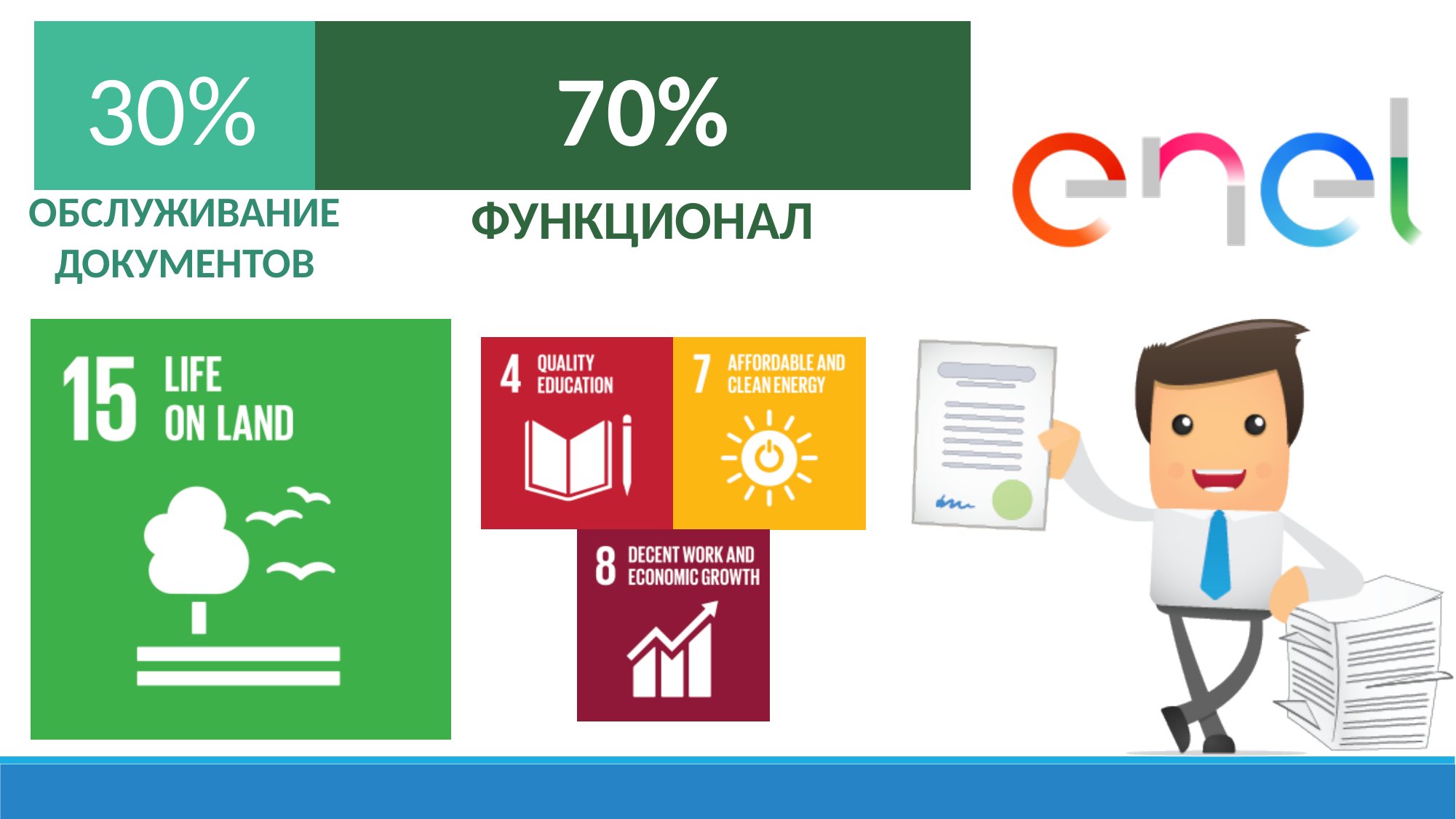
What is the difference between the ФУНКЦИОНАЛ share and the ОБСЛУЖИВАНИЕ ДОКУМЕНТОВ share? 40% Which segment has the larger share, ОБСЛУЖИВАНИЕ ДОКУМЕНТОВ or ФУНКЦИОНАЛ? ФУНКЦИОНАЛ How many segments does the bar have? 2 Which category has the smallest share in the bar? ОБСЛУЖИВАНИЕ ДОКУМЕНТОВ Which colour is the ФУНКЦИОНАЛ segment, light green or dark green? Dark green What percentage is shown for ОБСЛУЖИВАНИЕ ДОКУМЕНТОВ? 30% What percentage is shown for ФУНКЦИОНАЛ? 70% What is the total of the two segments in the bar? 100% What kind of chart is the 30% / 70% graphic? Bar chart